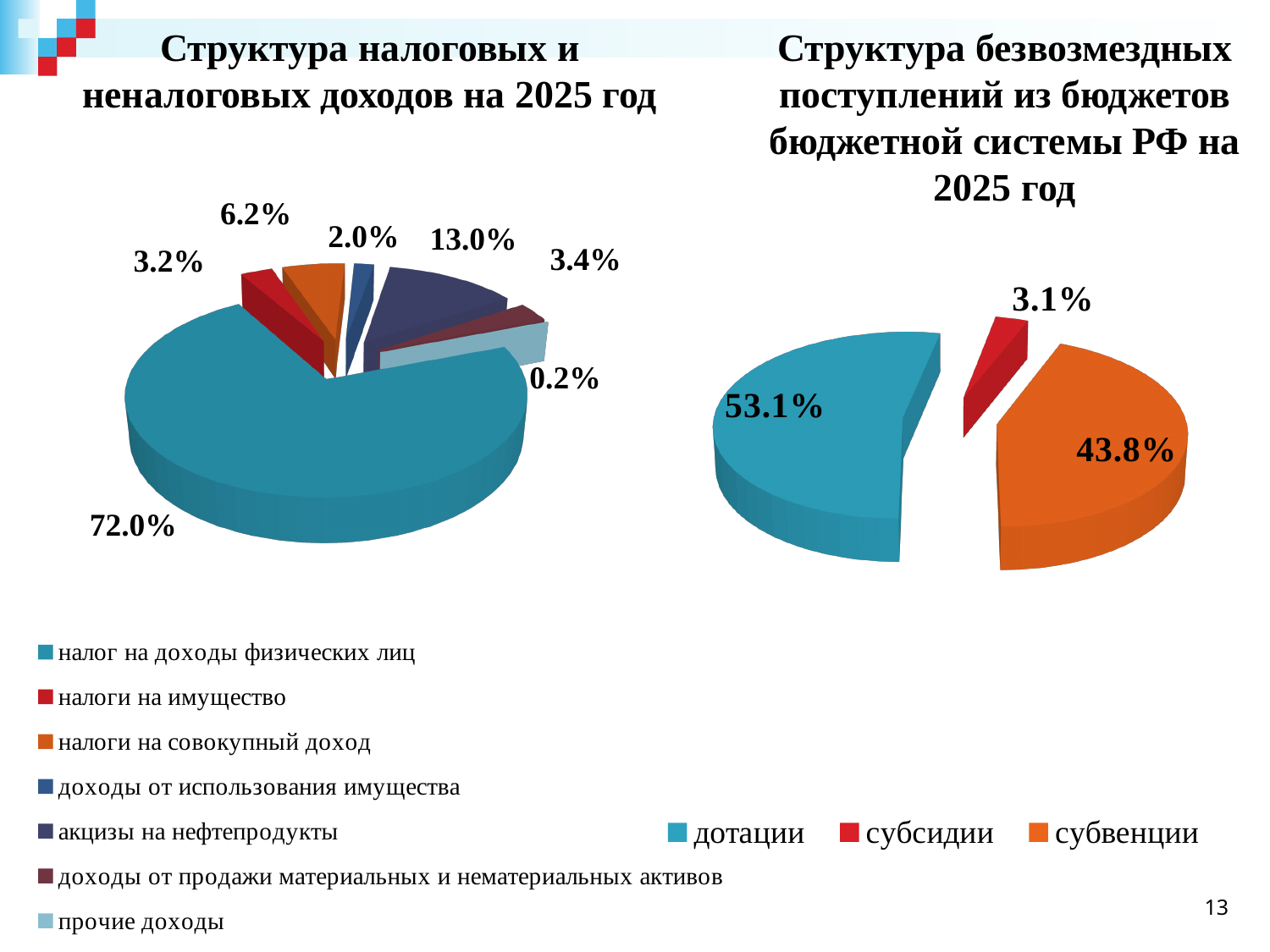
In the chart 'Структура безвозмездных поступлений из бюджетов бюджетной системы РФ на 2025 год', which category has the smallest share? субсидии In the chart 'Структура налоговых и неналоговых доходов на 2025 год', what share does 'налоги на совокупный доход' have? 6.2% In the chart 'Структура налоговых и неналоговых доходов на 2025 год', which category has the smallest share? прочие доходы What type of chart is used for 'Структура безвозмездных поступлений из бюджетов бюджетной системы РФ на 2025 год'? pie chart In the chart 'Структура безвозмездных поступлений из бюджетов бюджетной системы РФ на 2025 год', what share do 'субвенции' have? 43.8% In the chart 'Структура безвозмездных поступлений из бюджетов бюджетной системы РФ на 2025 год', what share do 'дотации' have? 53.1% In the chart 'Структура налоговых и неналоговых доходов на 2025 год', which category has the largest share? налог на доходы физических лиц In the chart 'Структура налоговых и неналоговых доходов на 2025 год', what share does 'налог на доходы физических лиц' have? 72.0% In the chart 'Структура безвозмездных поступлений из бюджетов бюджетной системы РФ на 2025 год', which is larger: 'дотации' or 'субвенции'? дотации In the chart 'Структура налоговых и неналоговых доходов на 2025 год', what is the difference between the shares of 'акцизы на нефтепродукты' and 'налоги на совокупный доход'? 6.8% In the chart 'Структура налоговых и неналоговых доходов на 2025 год', how many categories does the legend list? 7 In the chart 'Структура налоговых и неналоговых доходов на 2025 год', what share does 'акцизы на нефтепродукты' have? 13.0%